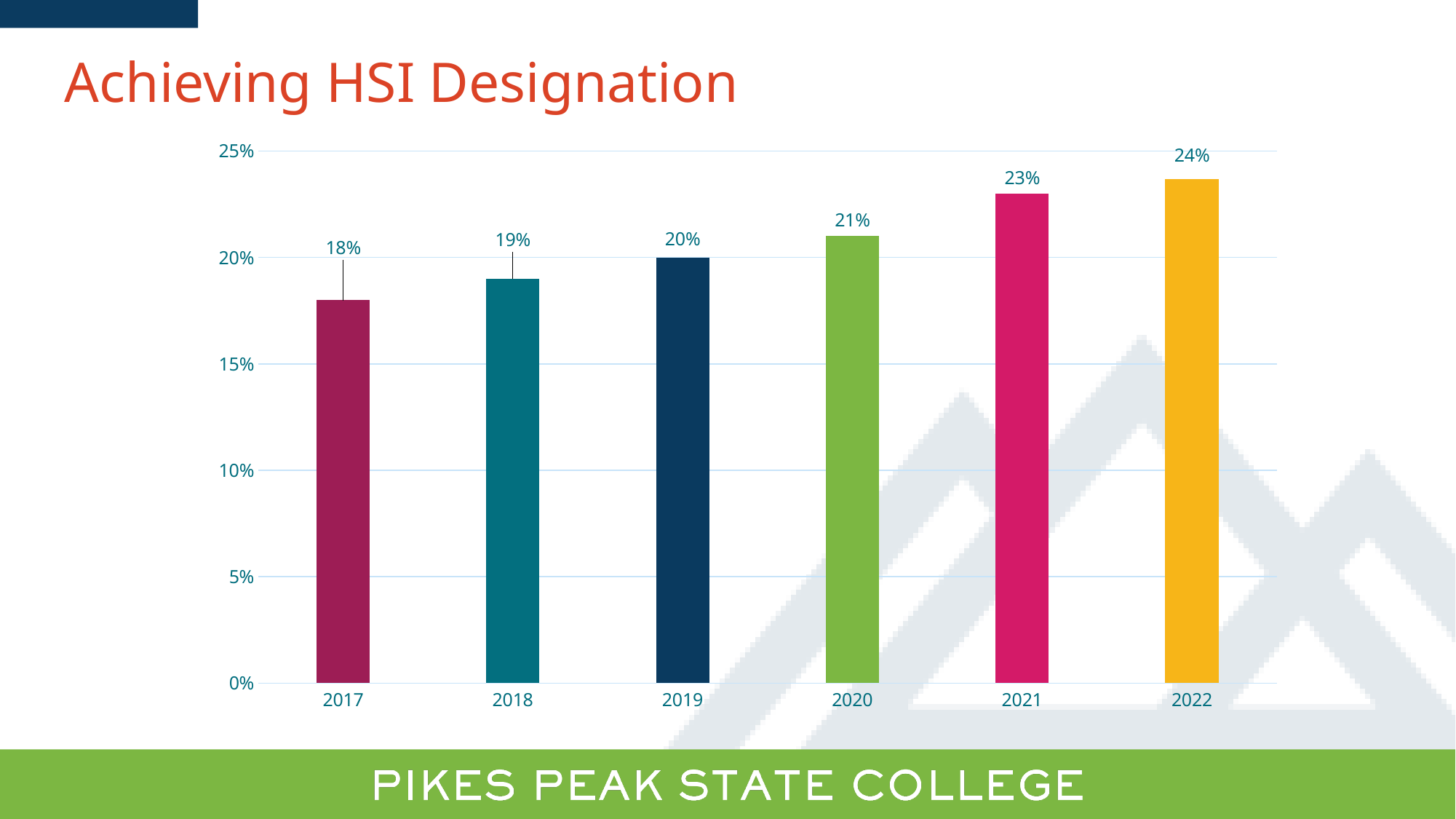
What kind of chart is shown on the slide? bar chart What is the difference between the values for 2022 and 2017? 6% What is the value for 2017? 18% How many years are shown on the x axis? 6 What is the value for 2020? 21% Which year has the lowest value? 2017 Which is larger, the value for 2019 or the value for 2021? 2021 What is the difference between the values for 2021 and 2020? 2% Which year has the highest value? 2022 Is the value for 2018 greater or less than 20%? less What is the value for 2022? 24% Do the values rise or fall from 2017 to 2022? rise